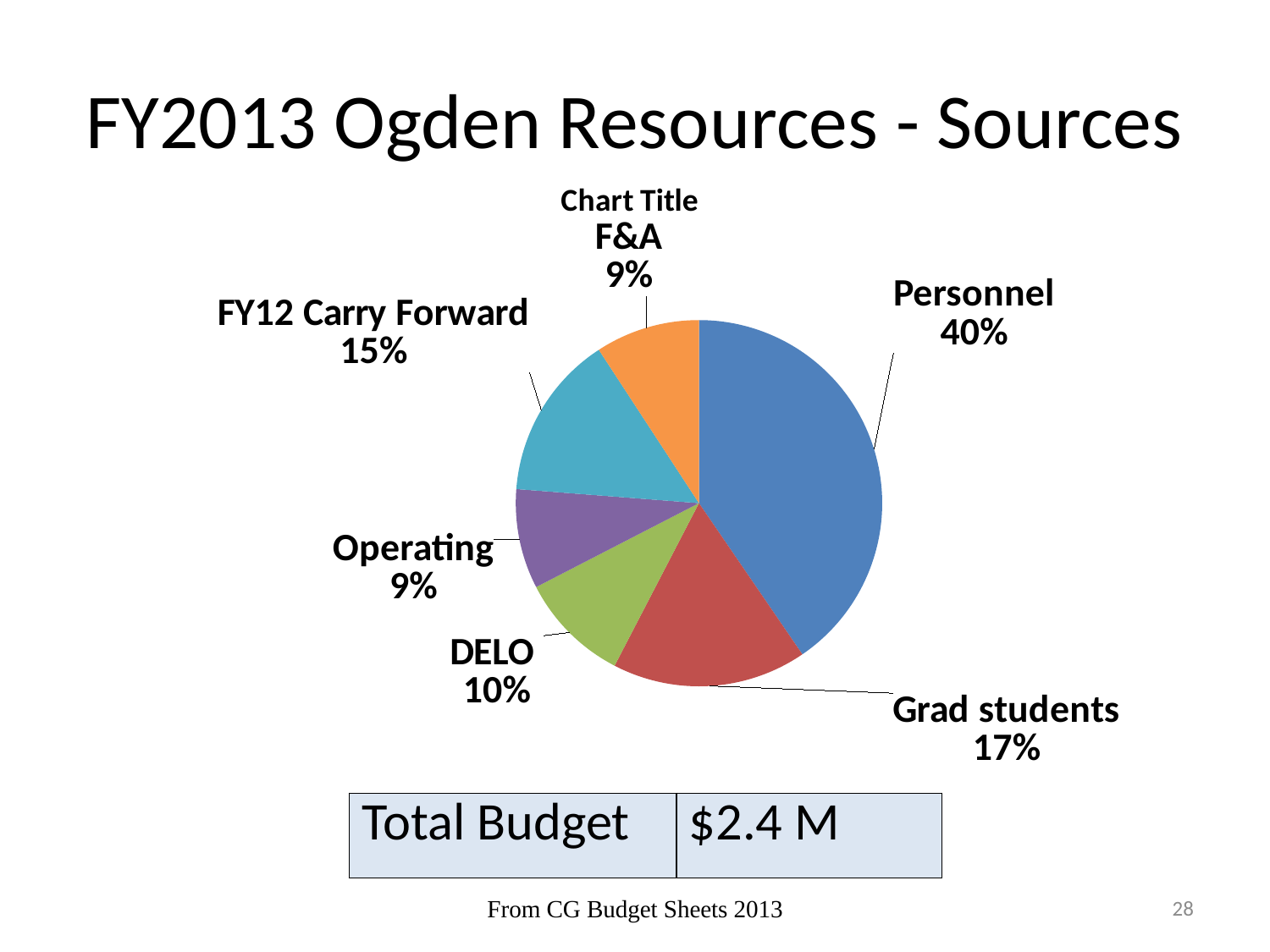
What title is printed above the pie chart? Chart Title What percentage is shown for DELO? 10% What is the difference in percentage points between Personnel and Grad students? 23 Which category has the largest slice of the pie? Personnel What share of the pie does Personnel represent? 40% What percentage is shown for Grad students? 17% Which is larger, the FY12 Carry Forward slice or the DELO slice? FY12 Carry Forward What kind of chart is shown on the slide? pie chart What percentage is shown for FY12 Carry Forward? 15% What is the difference in percentage points between FY12 Carry Forward and Operating? 6 How many slices does the pie chart have? 6 What colour is the Personnel slice? blue